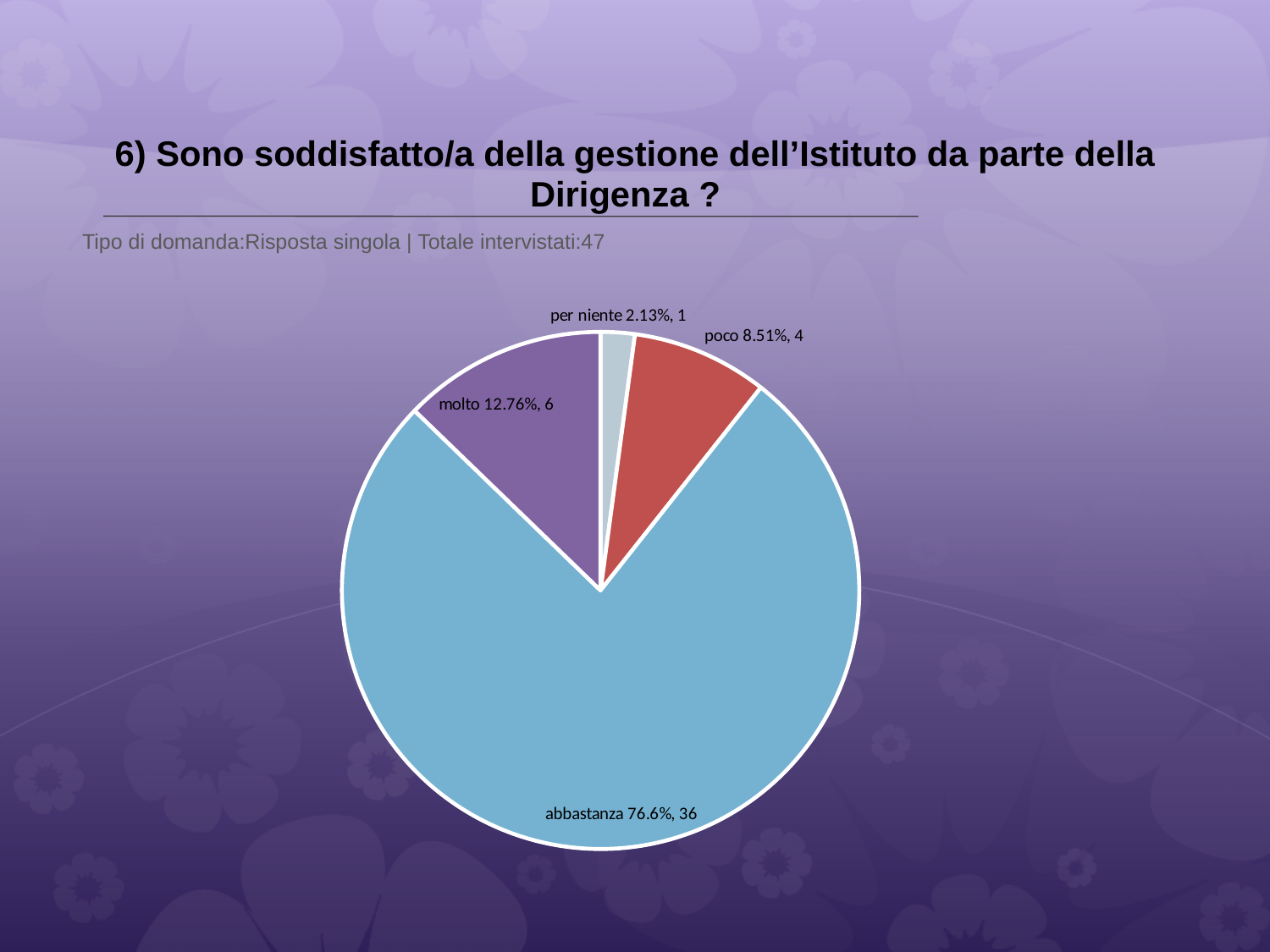
What is the total number of respondents shown in the subtitle? 47 Which has more respondents, 'molto' or 'poco'? molto What percentage share does the 'molto' slice have? 12.76% What percentage share does the 'per niente' slice have? 2.13% How many respondents answered 'molto'? 6 How many respondents answered 'poco'? 4 What is the difference in respondent count between 'abbastanza' and 'molto'? 30 Which category has the smallest slice? per niente What kind of chart is shown on the slide? pie chart What percentage share does the 'abbastanza' slice have? 76.6% How many slices does the pie chart have? 4 Which category has the largest slice? abbastanza